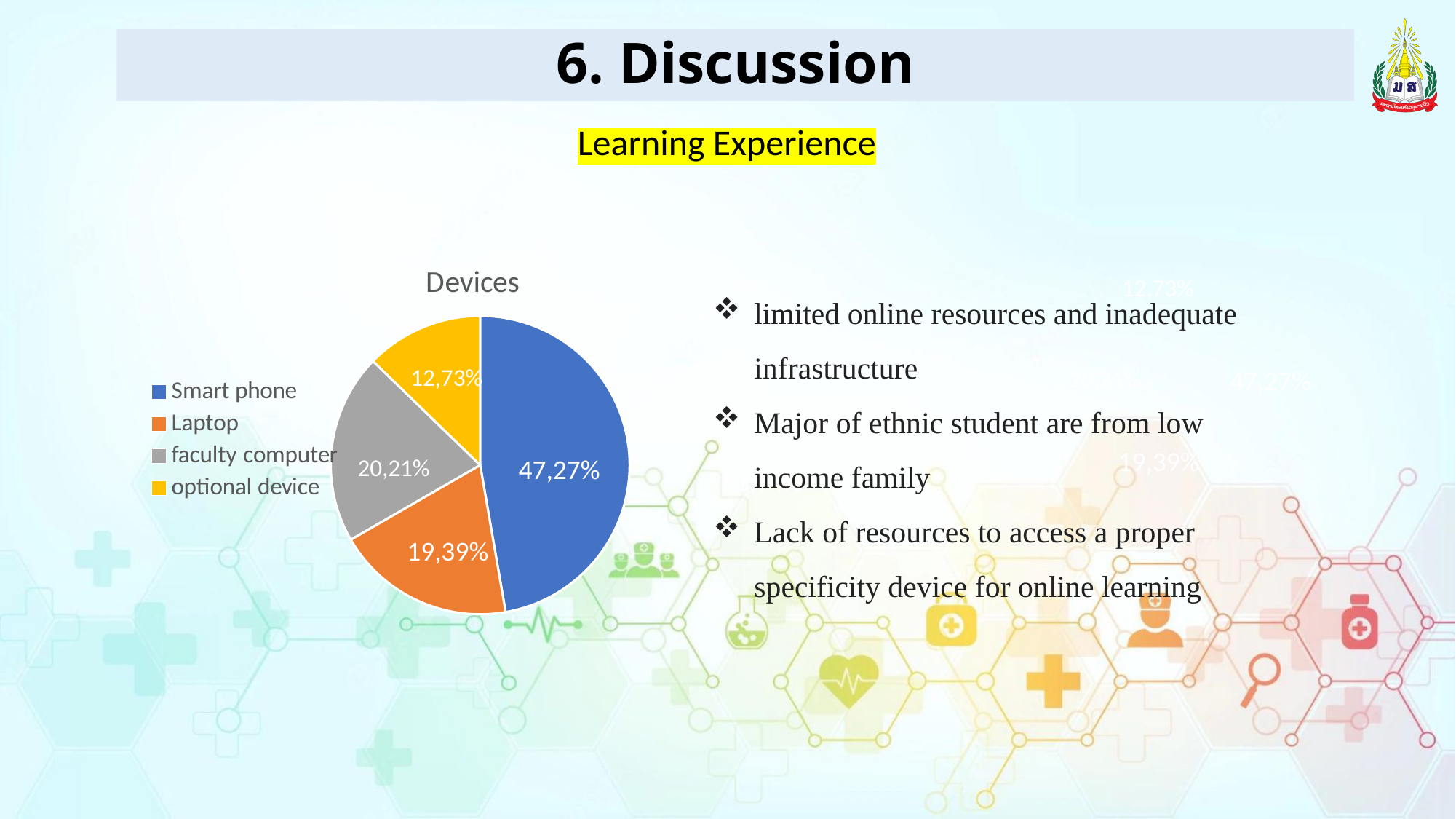
What share of the pie does Smart phone have? 47,27% Which colour represents faculty computer in the pie chart? grey Which is larger, the share for Smart phone or the share for Laptop? Smart phone What kind of chart is shown on the slide? pie chart What share of the pie does optional device have? 12,73% How many categories does the pie chart show? 4 What is the title of the chart? Devices What share of the pie does faculty computer have? 20,21% Which category has the smallest slice of the pie? optional device What is the difference in percentage points between the Smart phone share and the optional device share? 34,54 Which category has the largest slice of the pie? Smart phone What share of the pie does Laptop have? 19,39%